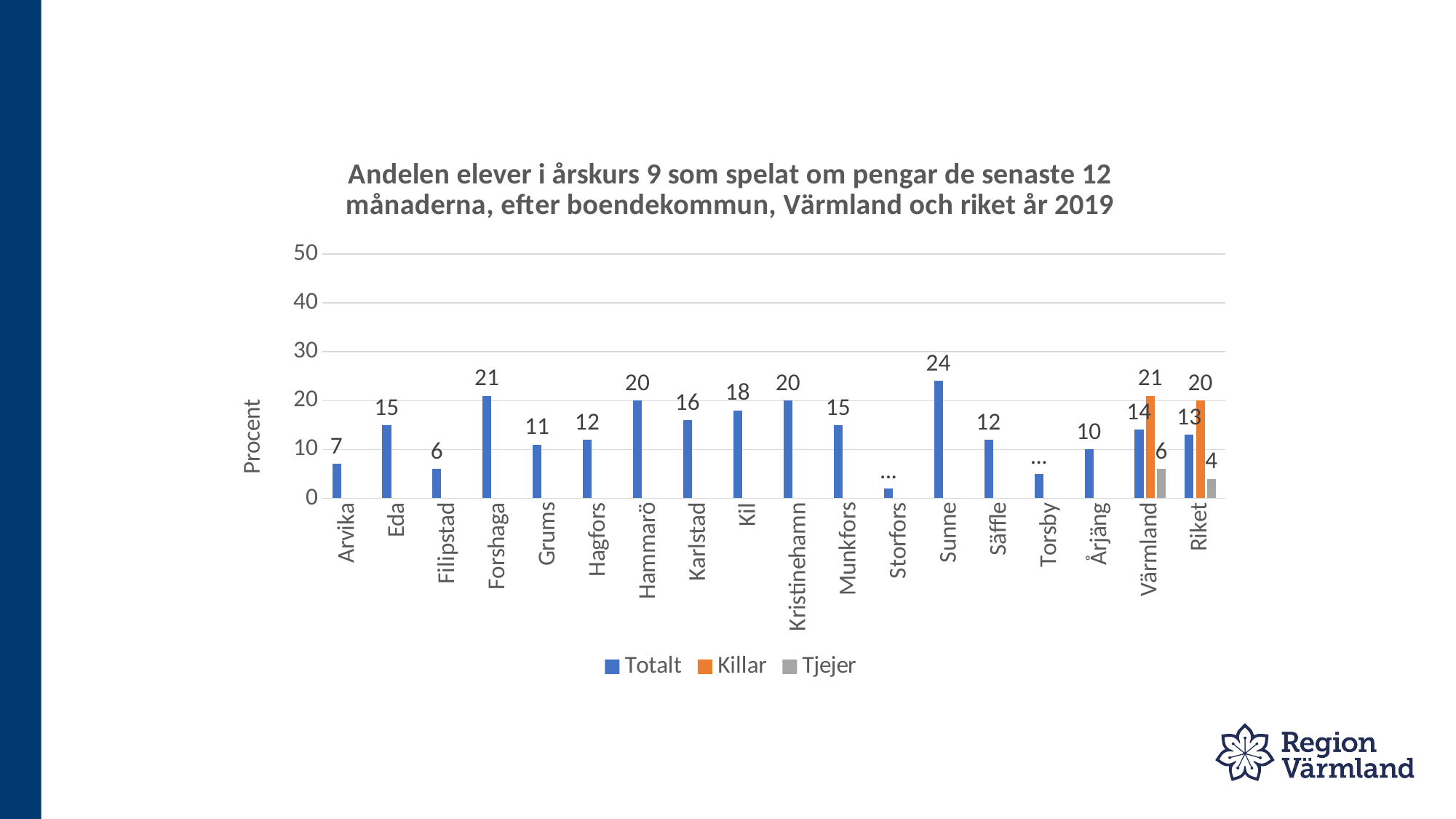
What kind of chart is shown on the slide? bar chart What is the Killar value for Värmland? 21 What is the Tjejer value for Riket? 4 What is the label of the y axis? Procent What is the difference between the Totalt values for Hammarö and Arvika? 13 Which has a higher Totalt value, Forshaga or Karlstad? Forshaga How many categories are shown on the x axis? 18 What is the difference between the Killar and Tjejer values for Värmland? 15 Is the Totalt value for Storfors greater or less than 10? less How many series does the legend list? 3 What is the Totalt value for Sunne? 24 Which municipality has the highest Totalt value? Sunne